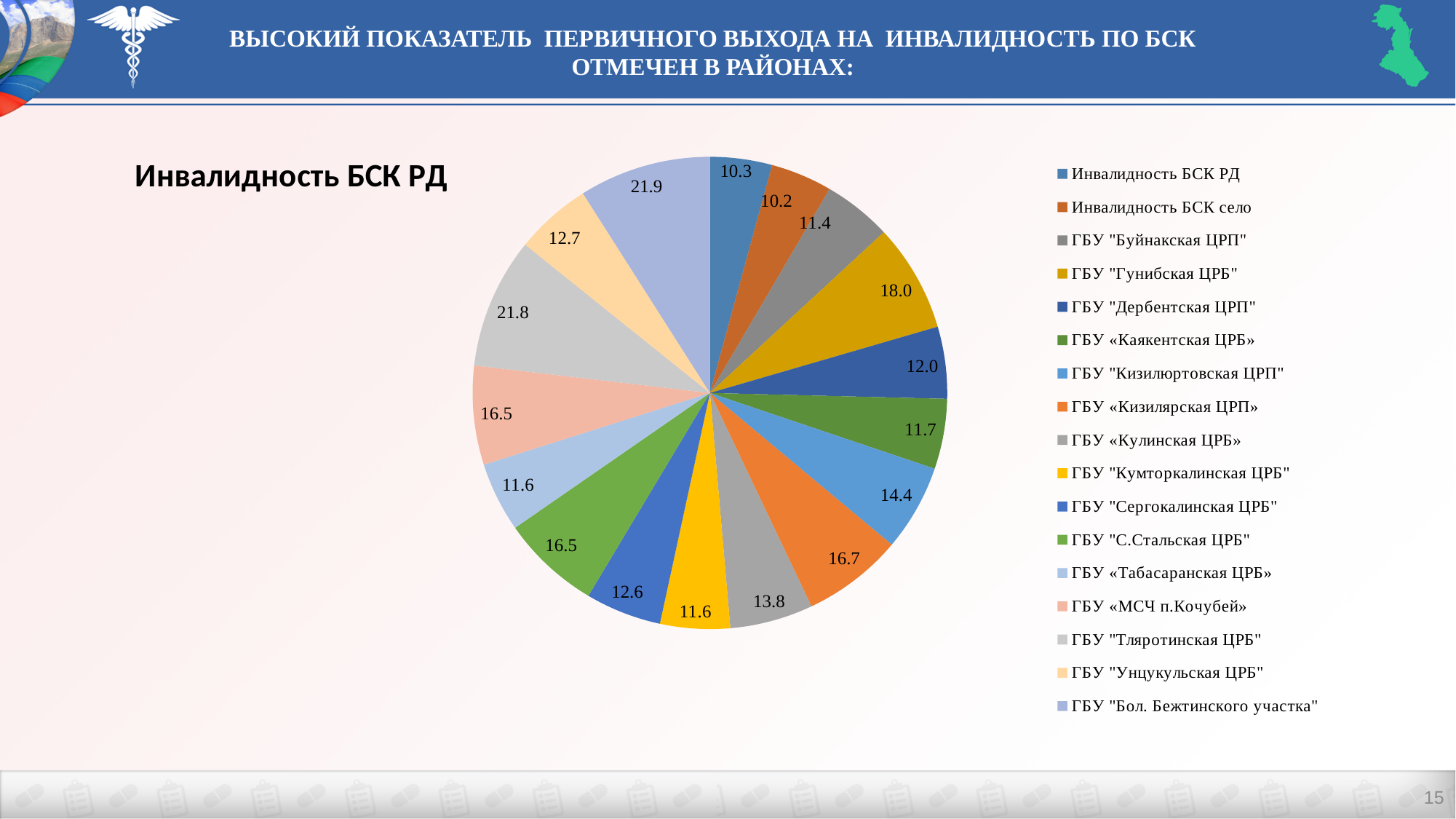
What is the difference between the values for ГБУ "Гунибская ЦРБ" and ГБУ "Дербентская ЦРП"? 6.0 What is the difference between the values for ГБУ "Бол. Бежтинского участка" and ГБУ "Унцукульская ЦРБ"? 9.2 Which legend entry is shown with a yellow colour and a value of 11.6? ГБУ "Кумторкалинская ЦРБ" What is the value for ГБУ «Кизилярская ЦРП»? 16.7 What kind of chart is shown on the slide? pie chart What is the value for ГБУ "Гунибская ЦРБ"? 18.0 What is the title of the chart? Инвалидность БСК РД What is the value for ГБУ "Тляротинская ЦРБ"? 21.8 How many slices does the pie chart have? 17 What is the value for ГБУ "Кизилюртовская ЦРП"? 14.4 Which is larger, the value for ГБУ «Кулинская ЦРБ» or the value for ГБУ "С.Стальская ЦРБ"? ГБУ "С.Стальская ЦРБ" What is the value for Инвалидность БСК село? 10.2